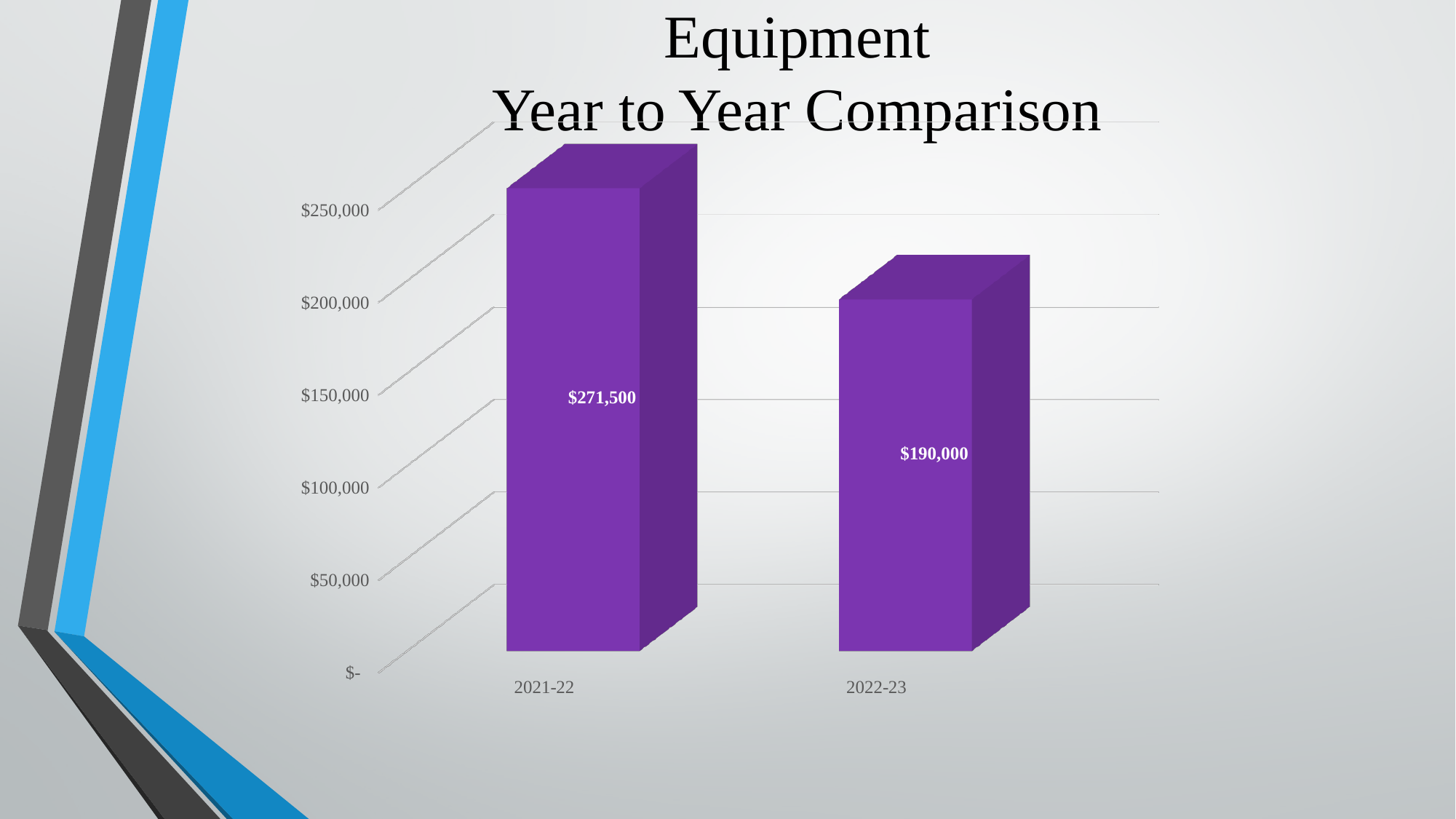
What is the equipment value for 2022-23? $190,000 What is the equipment value for 2021-22? $271,500 Which year has the higher equipment value? 2021-22 Do the values rise or fall from 2021-22 to 2022-23? fall Is the value for 2022-23 greater or less than $200,000? less Is the value for 2021-22 larger or smaller than the value for 2022-23? larger What is the difference between the 2021-22 and 2022-23 equipment values? $81,500 Which year has the lower equipment value? 2022-23 What kind of chart is shown on the slide? bar chart How many years are shown on the chart? 2 What is the title of the chart? Equipment Year to Year Comparison Is the value for 2021-22 greater or less than $250,000? greater